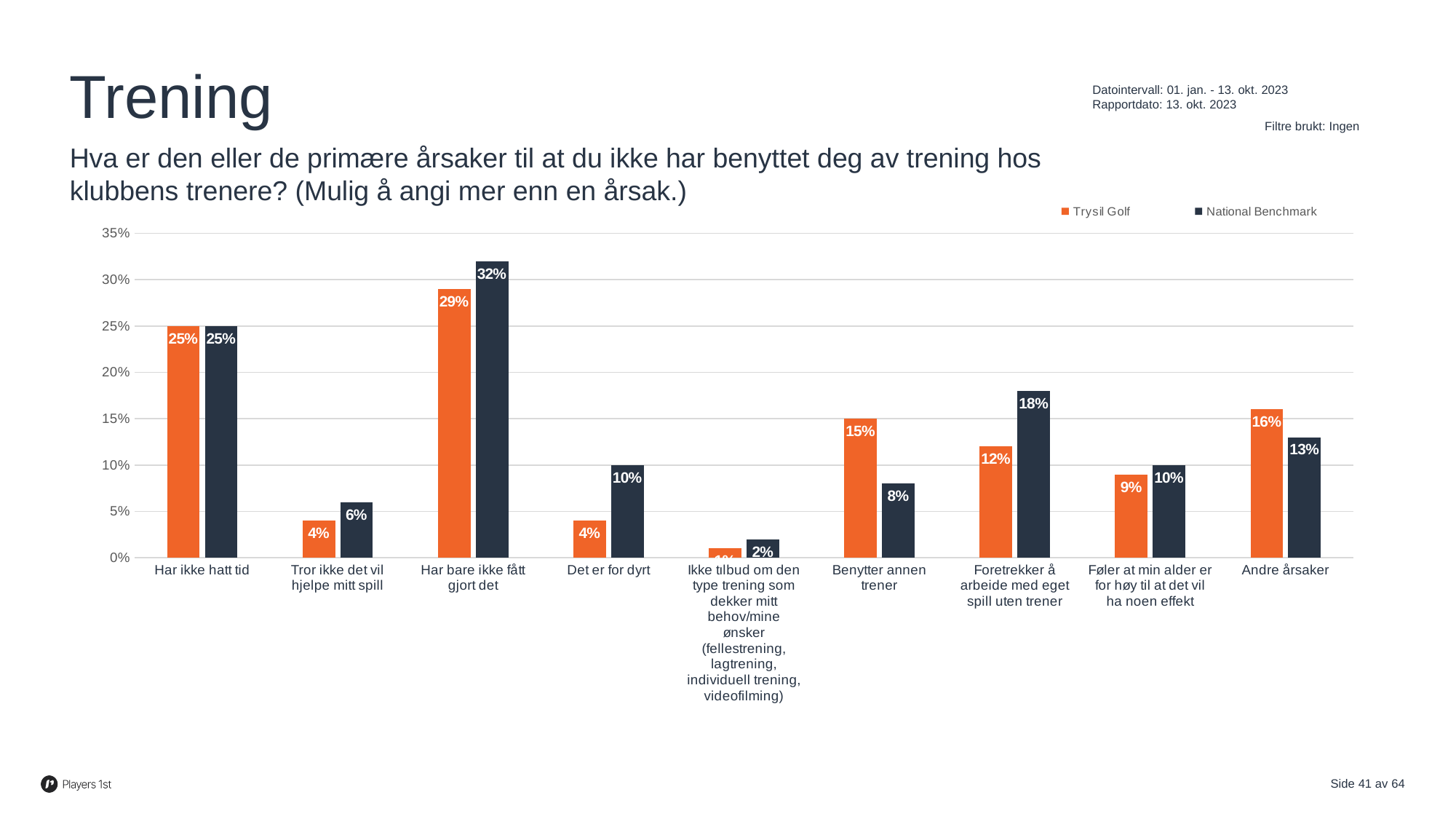
How many series does the legend list? 2 Is the Trysil Golf value for "Andre årsaker" greater or less than 15%? greater What kind of chart is shown on the slide? Bar chart Which category has the lowest Trysil Golf value? Ikke tilbud om den type trening som dekker mitt behov/mine ønsker (fellestrening, lagtrening, individuell trening, videofilming) For "Benytter annen trener", which series has the larger value, Trysil Golf or National Benchmark? Trysil Golf What is the National Benchmark value for "Det er for dyrt"? 10% What is the Trysil Golf value for "Benytter annen trener"? 15% Which category has the highest National Benchmark value? Har bare ikke fått gjort det What is the difference between the National Benchmark and Trysil Golf values for "Det er for dyrt"? 6% What is the National Benchmark value for "Foretrekker å arbeide med eget spill uten trener"? 18% What is the Trysil Golf value for "Har bare ikke fått gjort det"? 29% How many categories are shown on the x axis? 9